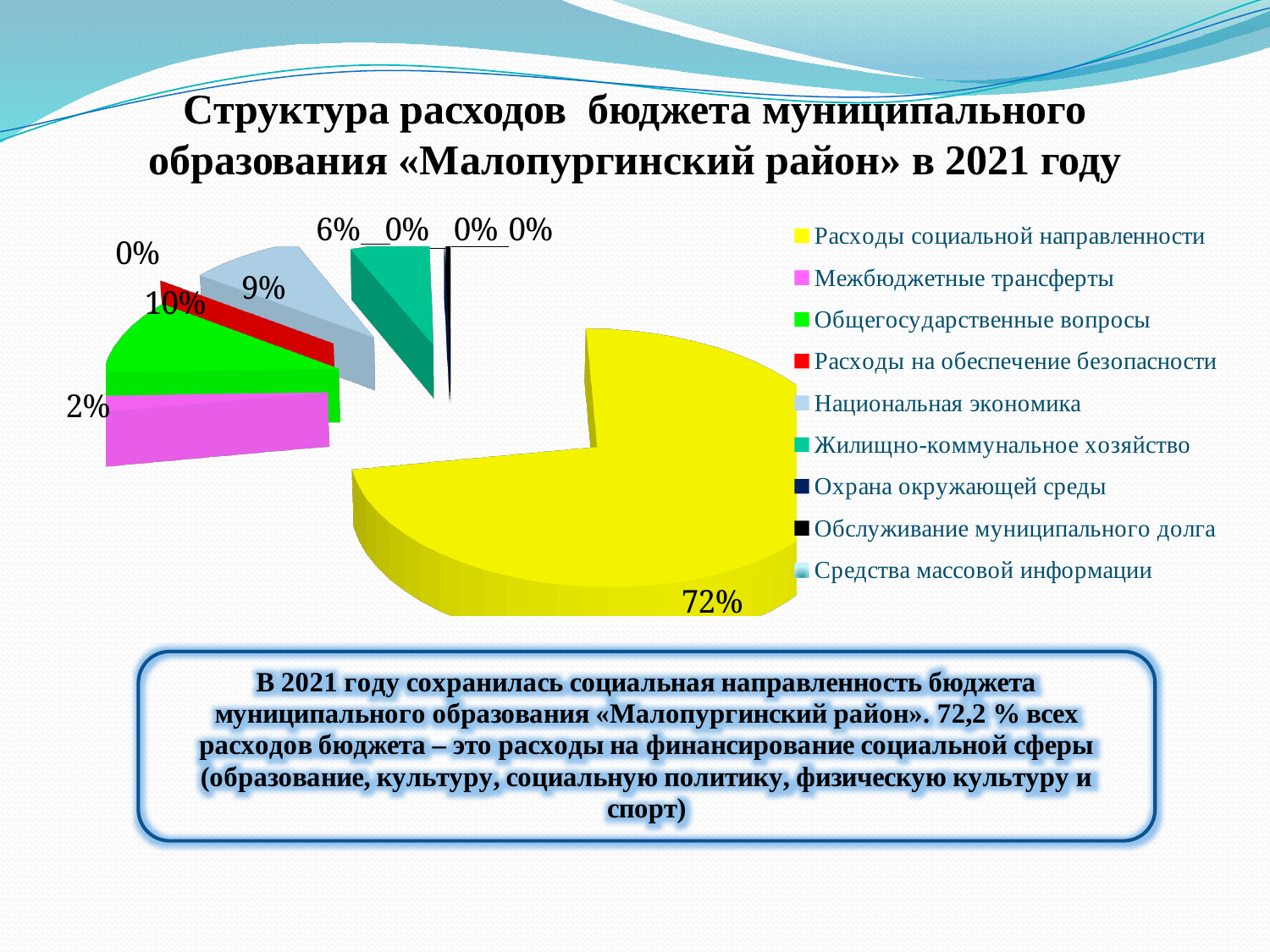
What share of the pie is labelled for Расходы социальной направленности? 72% Which is larger: the slice labelled 9% or the slice labelled 6%? the slice labelled 9% What is the title of the chart on the slide? Структура расходов бюджета муниципального образования «Малопургинский район» в 2021 году What is the largest percentage label shown on the pie chart? 72% What kind of chart is shown on the slide? pie chart How many slices of the pie chart are labelled 0%? 4 What is the smallest percentage label shown on the pie chart? 0% How many categories does the legend of the pie chart list? 9 Which category has the largest share of the pie chart? Расходы социальной направленности Is the share for Расходы социальной направленности greater or less than 50%? greater Which colour represents Расходы социальной направленности in the legend? yellow What is the difference between the largest labelled share (72%) and the second largest labelled share (10%)? 62%